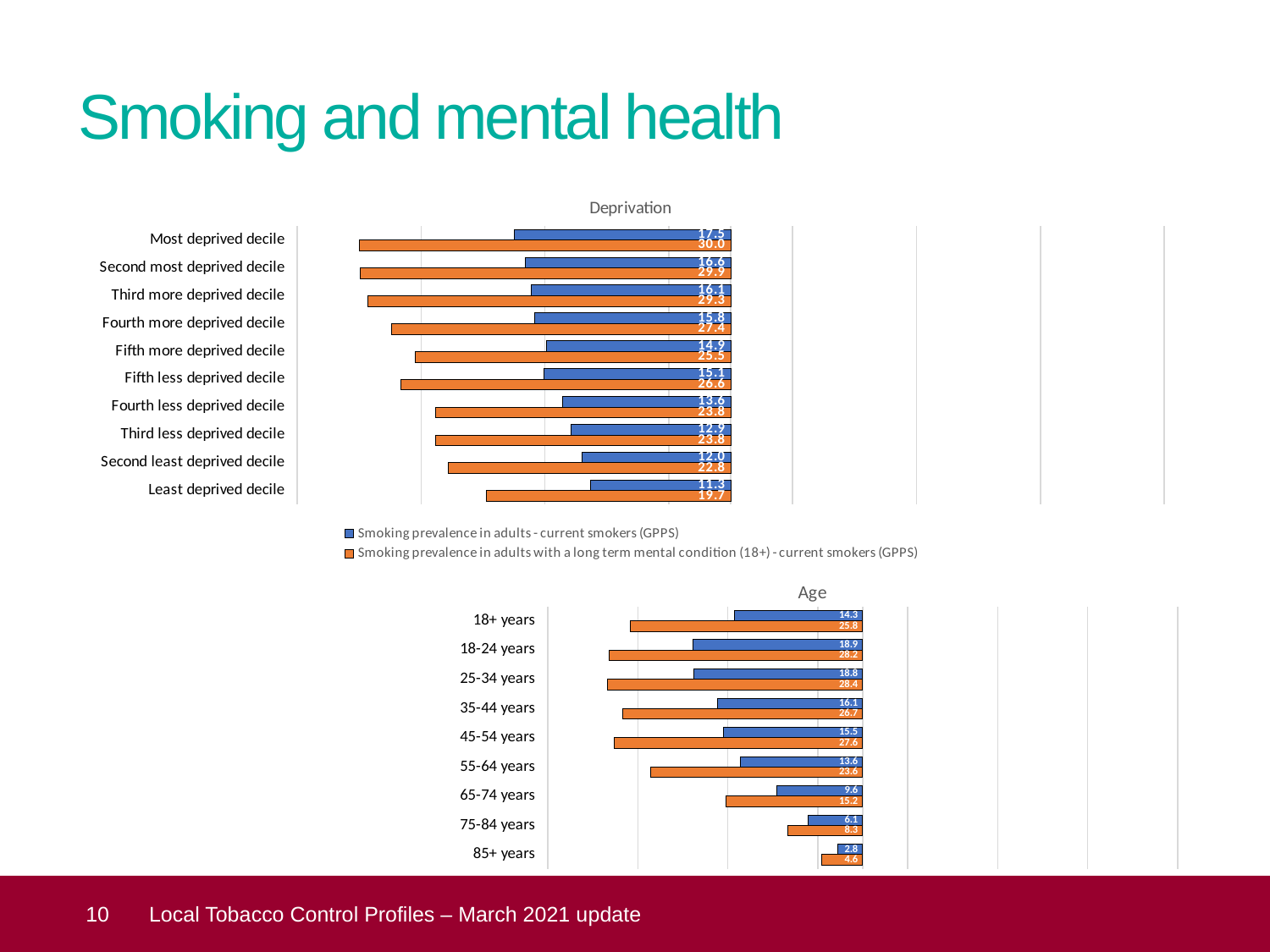
In the Deprivation chart, which decile has the highest smoking prevalence in adults with a long term mental condition? Most deprived decile In the Age chart, is the smoking prevalence in adults (current smokers) larger for 35-44 years or for 55-64 years? 35-44 years In the Age chart, which age group has the highest smoking prevalence in adults (current smokers)? 18-24 years In the Deprivation chart, which decile has the lowest smoking prevalence in adults (current smokers)? Least deprived decile What kind of chart is the Age chart? Bar chart In the Age chart, which age group has the lowest smoking prevalence in adults with a long term mental condition? 85+ years In the Deprivation chart, what is the difference between the two series for the Fourth more deprived decile? 11.6 In the Deprivation chart, what is the smoking prevalence in adults (current smokers) for the Least deprived decile? 11.3 In the Deprivation chart, how many deciles are shown? 10 In the Deprivation chart, what is the smoking prevalence in adults with a long term mental condition for the Most deprived decile? 30.0 In the Deprivation chart, how many series does the legend list? 2 In the Age chart, what is the smoking prevalence in adults with a long term mental condition for 45-54 years? 27.6